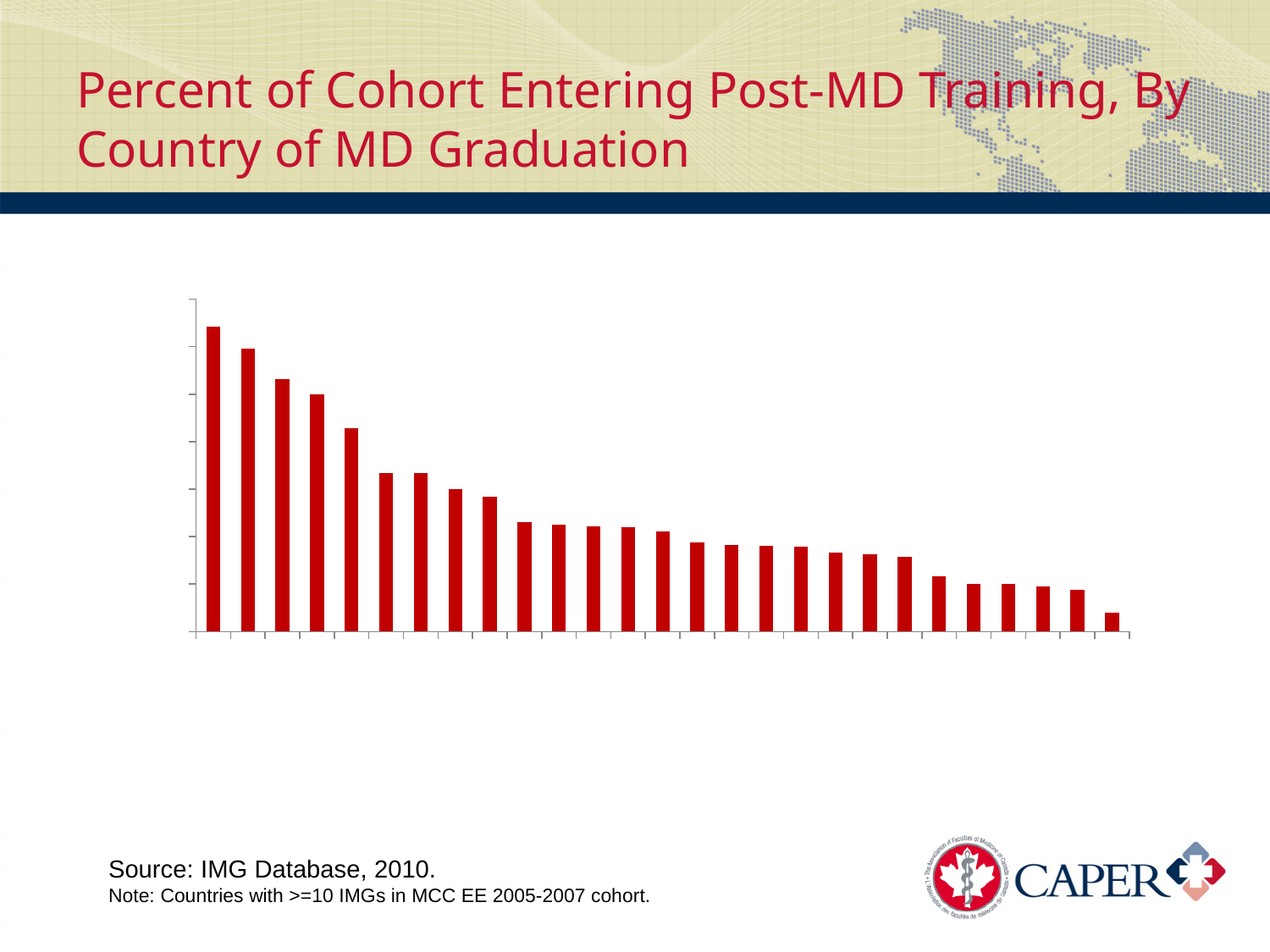
How many bars are plotted in the chart? 27 Do the bar values rise or fall from left to right across the chart? Fall What kind of chart is shown on the slide? Bar chart What colour are the bars in the chart? Red What is the title of the slide containing the chart? Percent of Cohort Entering Post-MD Training, By Country of MD Graduation